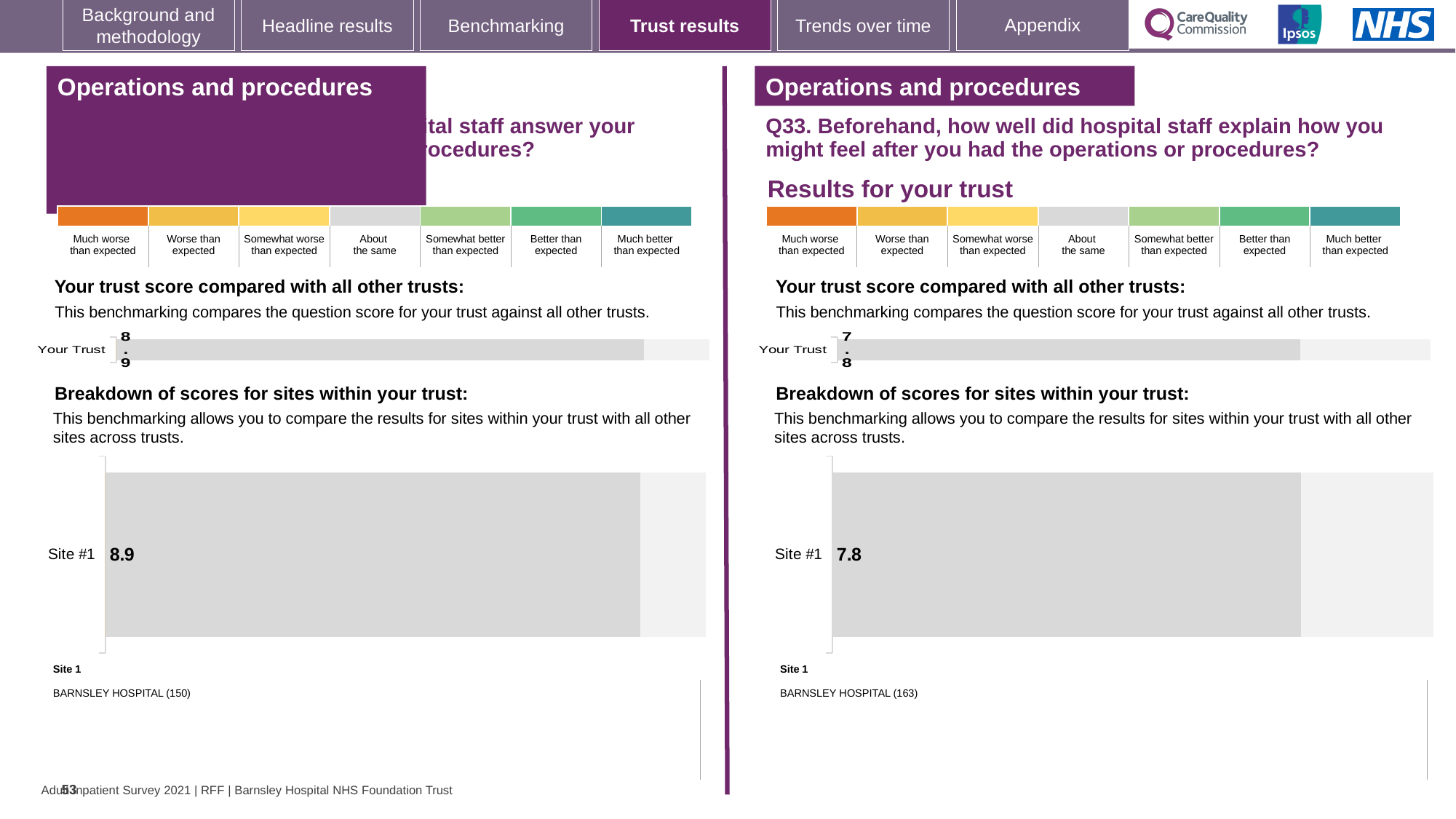
On the right-hand side for Q33, is the Your Trust score equal to the Site #1 score? Yes Which hospital is listed as Site 1 beneath the right-hand site breakdown chart for Q33? BARNSLEY HOSPITAL (163) What is the difference between the Site #1 score on the left-hand chart and the Site #1 score on the right-hand chart for Q33? 1.1 How many sites are shown in the site breakdown chart on the right-hand side for Q33? 1 On the right-hand chart for Q33, what is the score shown for Your Trust? 7.8 Which hospital is listed as Site 1 beneath the left-hand site breakdown chart? BARNSLEY HOSPITAL (150) Which is larger: the Your Trust score on the left-hand chart or the Your Trust score on the right-hand chart for Q33? Left-hand chart On the left-hand site breakdown chart, what is the score for Site #1? 8.9 How many sites are shown in the site breakdown chart on the left-hand side? 1 What type of chart is used to show the Your Trust score on the right-hand side for Q33? Bar chart On the left-hand chart, what is the score shown for Your Trust? 8.9 On the right-hand site breakdown chart for Q33, what is the score for Site #1? 7.8